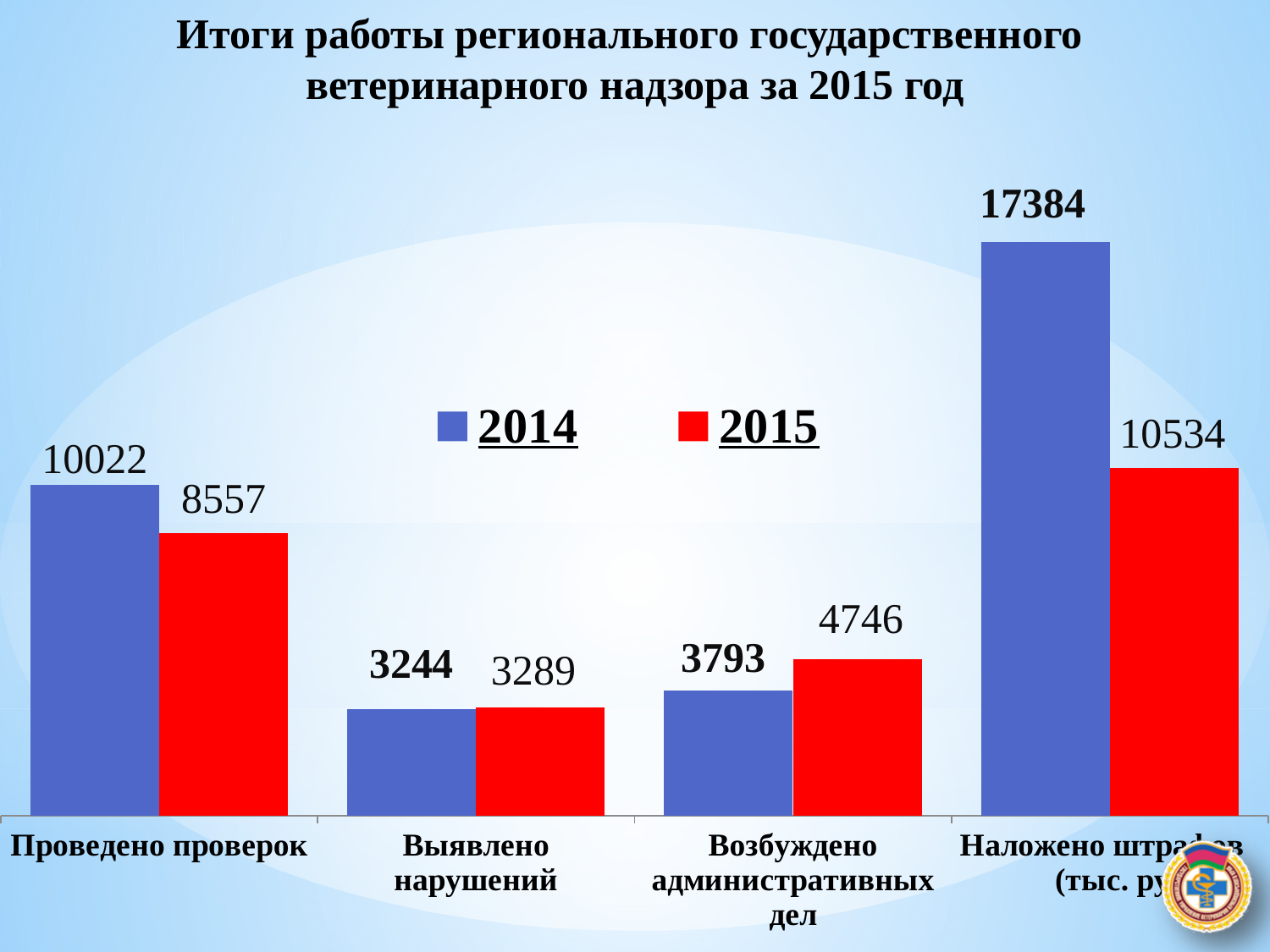
What is the 2015 value for "Возбуждено административных дел"? 4746 How many categories are shown on the x axis? 4 What is the difference between the 2014 and 2015 values for "Наложено штрафов"? 6850 What is the 2015 value for "Проведено проверок"? 8557 Which category has the lowest 2015 value? Выявлено нарушений Which series is shown in red in the legend? 2015 What type of chart is shown on the slide? bar chart What is the 2014 value for "Наложено штрафов"? 17384 Which category has the highest 2014 value? Наложено штрафов For "Возбуждено административных дел", which year has the larger value, 2014 or 2015? 2015 How many series does the legend list? 2 What is the 2014 value for "Проведено проверок"? 10022